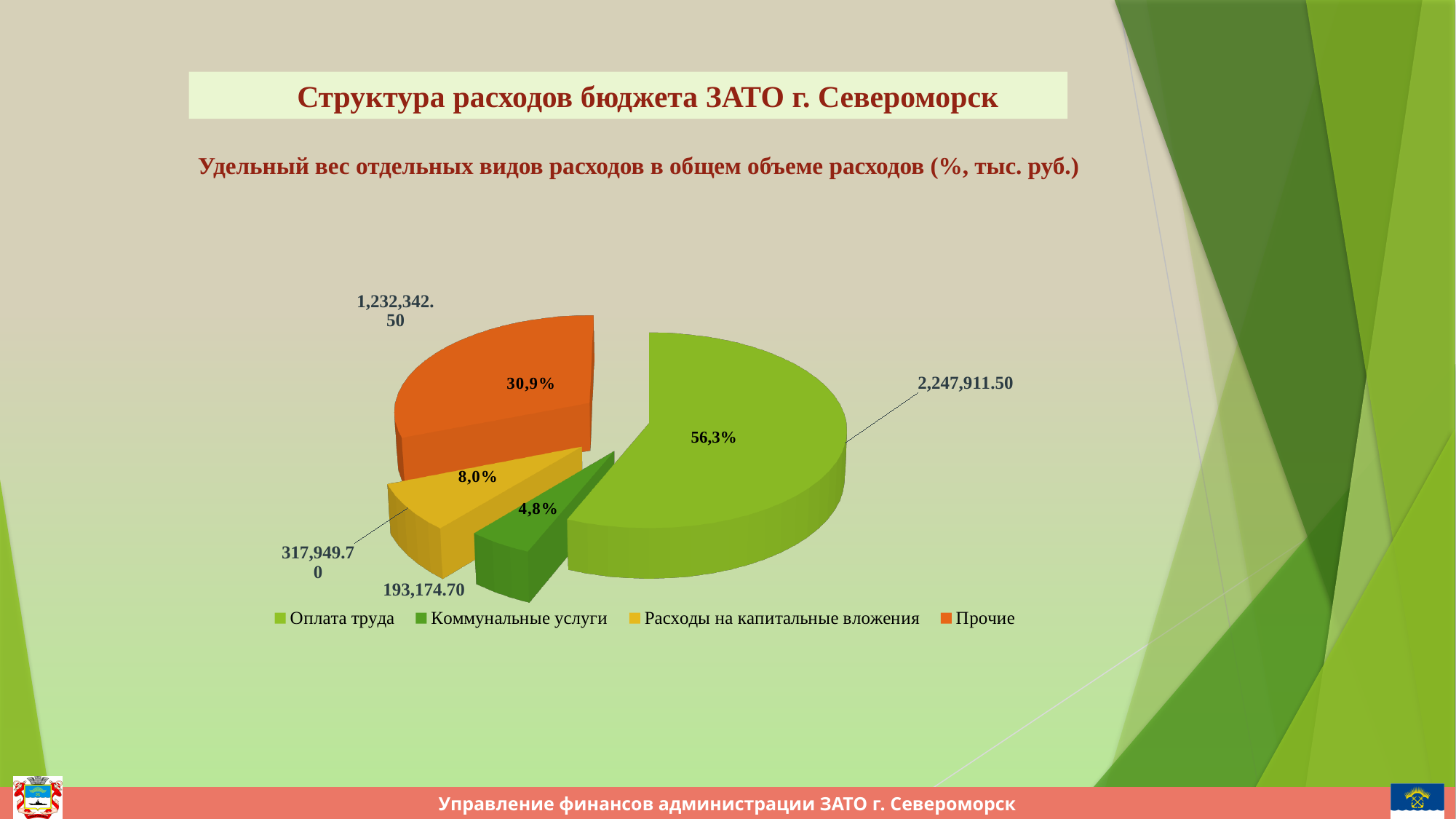
Which is larger, the share for Прочие or the share for Расходы на капитальные вложения? Прочие Which category has the largest slice of the pie? Оплата труда How many entries does the legend list? 4 What share of the pie does Прочие have? 30,9% What share of the pie does Оплата труда have? 56,3% What kind of chart is shown on the slide? pie chart Which category has the smallest slice of the pie? Коммунальные услуги What share of the pie does Коммунальные услуги have? 4,8% What value (тыс. руб.) is shown for Оплата труда? 2,247,911.50 How many slices does the pie chart have? 4 What value (тыс. руб.) is shown for Коммунальные услуги? 193,174.70